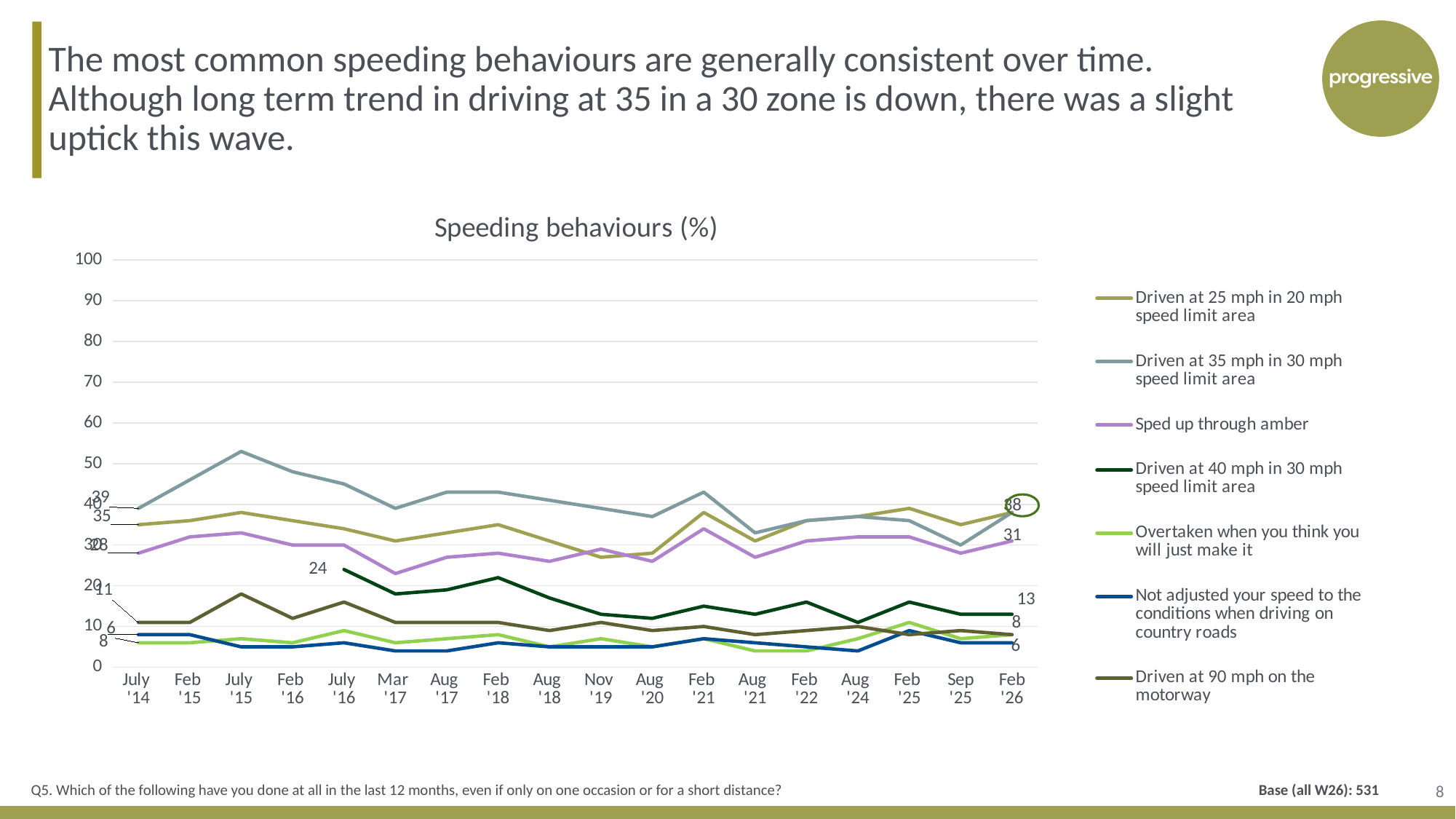
Which series has the highest value at July '15? Driven at 35 mph in 30 mph speed limit area What is the value for 'Driven at 40 mph in 30 mph speed limit area' at July '16? 24 What is the title of the chart? Speeding behaviours (%) At Feb '26, which is larger: 'Sped up through amber' or 'Driven at 40 mph in 30 mph speed limit area'? Sped up through amber How many time points are shown on the x axis? 18 What kind of chart is shown on the slide? line chart By how much did 'Driven at 40 mph in 30 mph speed limit area' fall between July '16 and Feb '26? 11 Is the value for 'Driven at 35 mph in 30 mph speed limit area' at July '15 greater or less than 50? greater What is the value for 'Driven at 40 mph in 30 mph speed limit area' at Feb '26? 13 How many series does the legend list? 7 What is the value for 'Driven at 35 mph in 30 mph speed limit area' at July '14? 39 What is the value for 'Sped up through amber' at Feb '26? 31